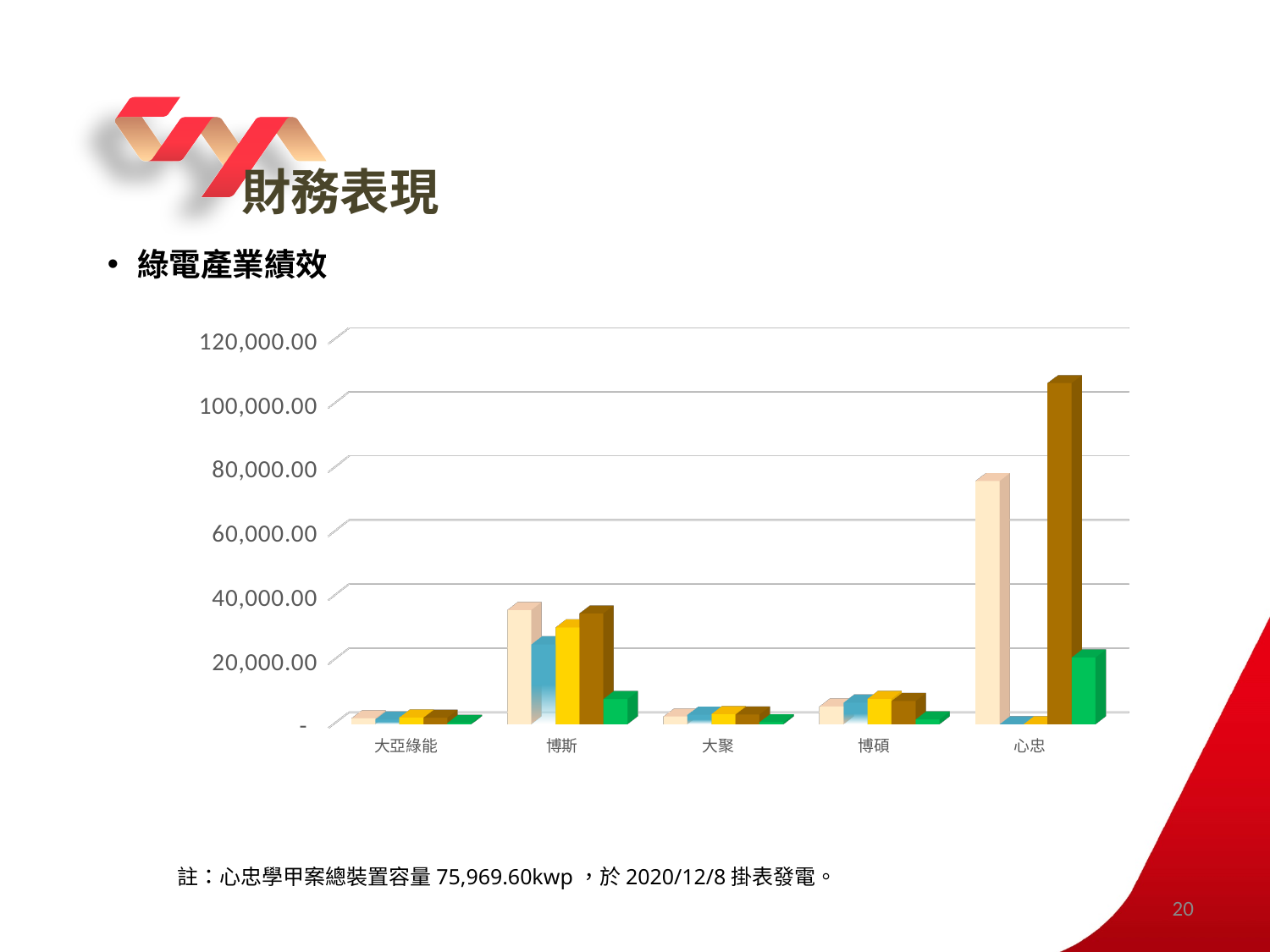
What kind of chart is shown on the slide? bar chart Is the value of the cream-coloured bar for 博斯 greater or less than 40,000.00? less Is the value of the cream-coloured bar for 心忠 greater or less than 80,000.00? less How many categories are shown on the x axis of the chart? 5 Is the value of the cream-coloured bar for 心忠 greater or less than 60,000.00? greater What is the highest value labelled on the vertical axis of the chart? 120,000.00 Which category has taller bars overall, 博斯 or 大聚? 博斯 Which has the larger cream-coloured bar, 博斯 or 心忠? 心忠 Which category has the tallest bar in the chart? 心忠